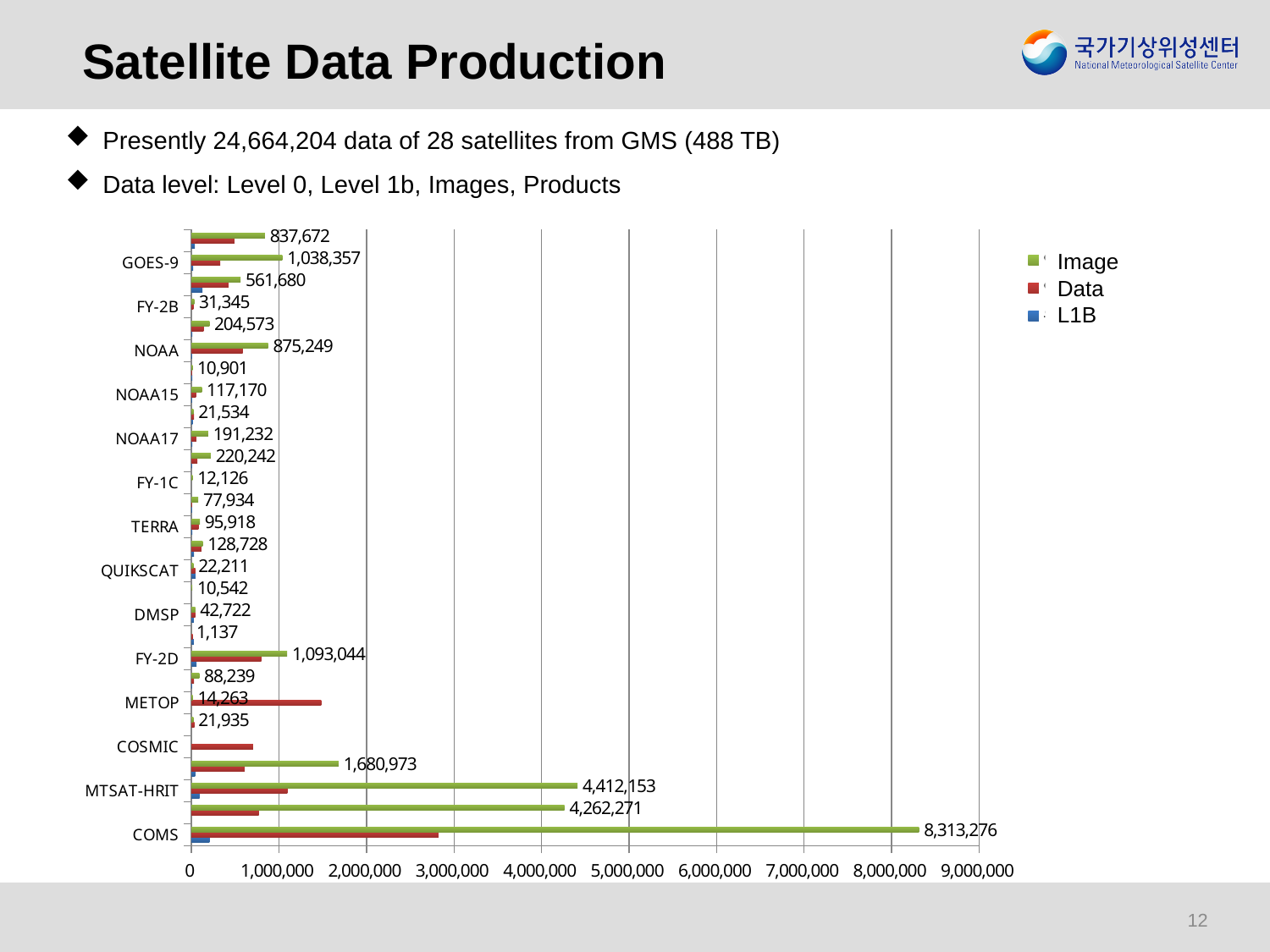
What is the Image value for GOES-9? 1,038,357 Which satellite has the highest Image value? COMS What kind of chart is shown on the slide? bar chart Is the Data value for METOP greater or less than 1,000,000? greater What are the three series named in the chart legend? Image, Data, L1B What is the Image value for NOAA? 875,249 What is the difference between the Image values for COMS and MTSAT-HRIT? 3,901,123 What is the Image value for FY-2D? 1,093,044 What is the Image value for COMS? 8,313,276 How many series does the chart legend list? 3 What is the Image value for MTSAT-HRIT? 4,412,153 Which has the larger Image value, GOES-9 or NOAA? GOES-9